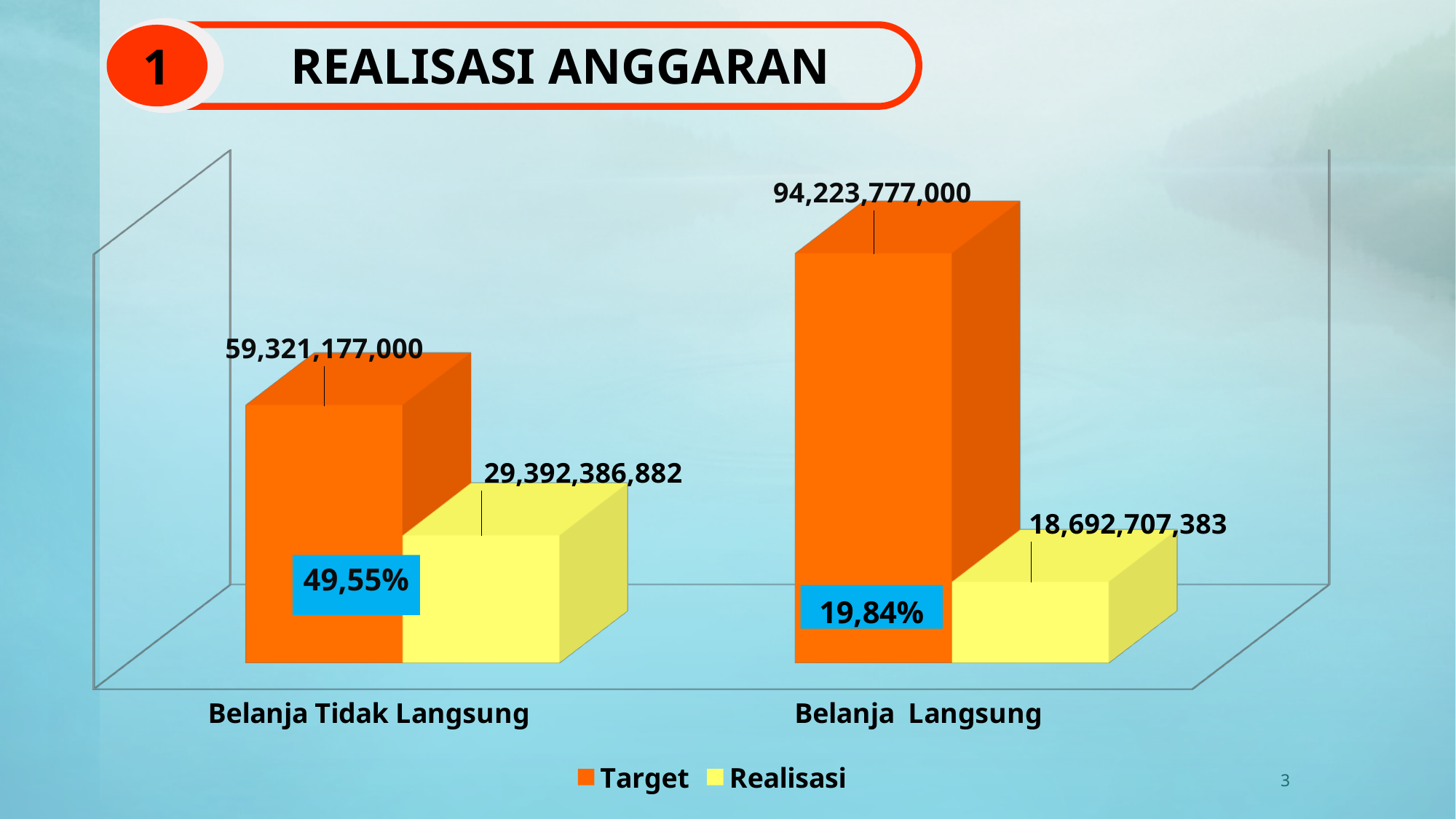
Which category has the highest Target value? Belanja Langsung Which is larger: the Realisasi value for Belanja Tidak Langsung or the Realisasi value for Belanja Langsung? Belanja Tidak Langsung What percentage is shown on the Belanja Langsung bars? 19,84% What is the difference between the Target values for Belanja Langsung and Belanja Tidak Langsung? 34,902,600,000 How many series does the legend list? 2 What is the difference between the Target and Realisasi values for Belanja Langsung? 75,531,069,617 Which category has the lowest Realisasi value? Belanja Langsung What is the Target value for Belanja Tidak Langsung? 59,321,177,000 What is the Target value for Belanja Langsung? 94,223,777,000 What is the Realisasi value for Belanja Langsung? 18,692,707,383 What is the Realisasi value for Belanja Tidak Langsung? 29,392,386,882 What type of chart is shown on the slide? Bar chart